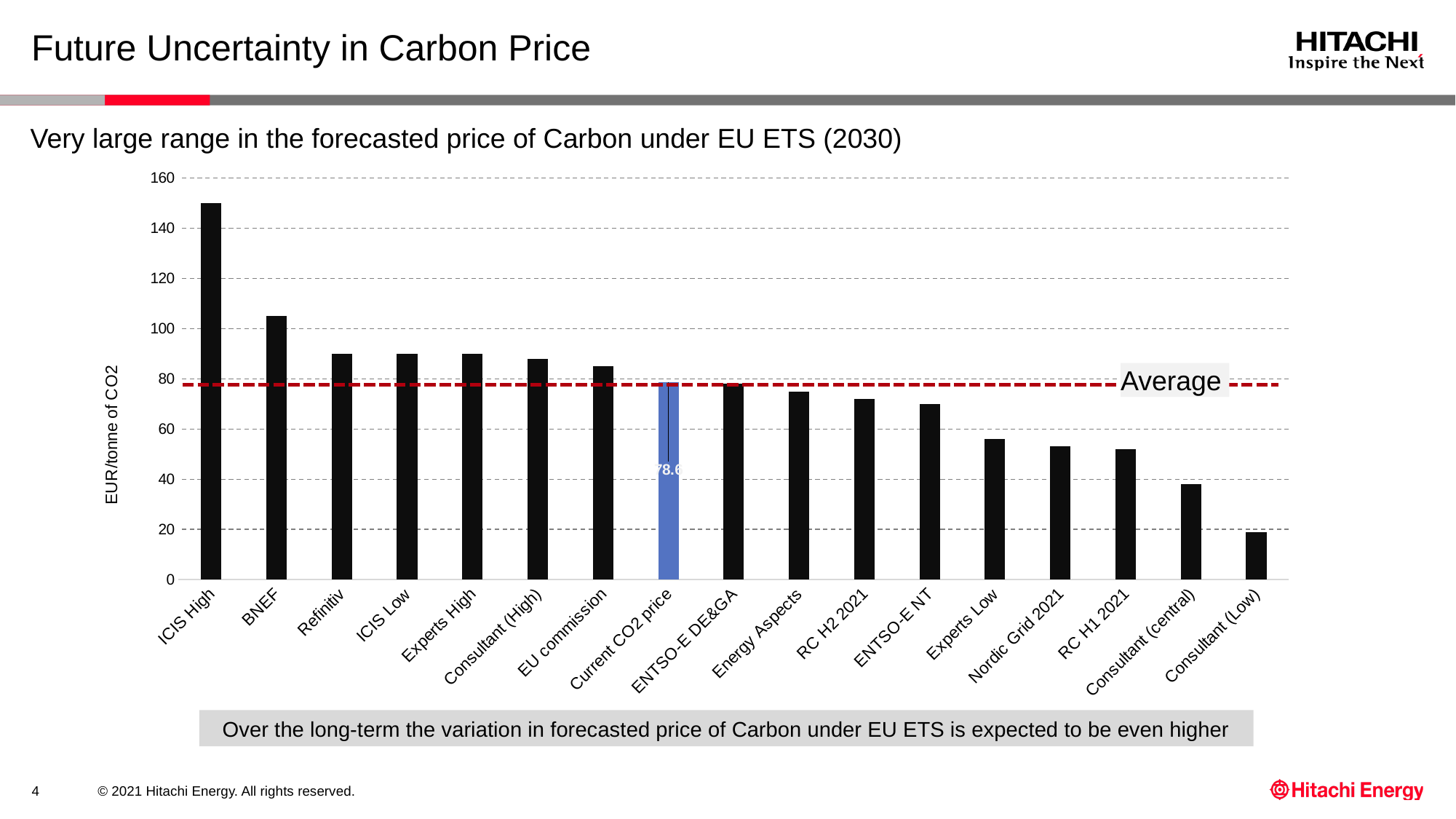
Which category has the highest forecasted carbon price? ICIS High Which bar is highlighted in blue rather than black? Current CO2 price Which category has the lowest forecasted carbon price? Consultant (Low) Which is larger, the value for BNEF or the value for Refinitiv? BNEF What is the label on the vertical axis of the chart? EUR/tonne of CO2 What kind of chart is shown on the slide? bar chart How many categories (bars) are plotted in the chart? 17 Is the value for Energy Aspects greater or less than 80? less Is the value for Consultant (central) greater or less than 40? less Do the bar values rise or fall moving from left to right along the x axis? fall Is the value for ICIS High greater or less than 140? greater